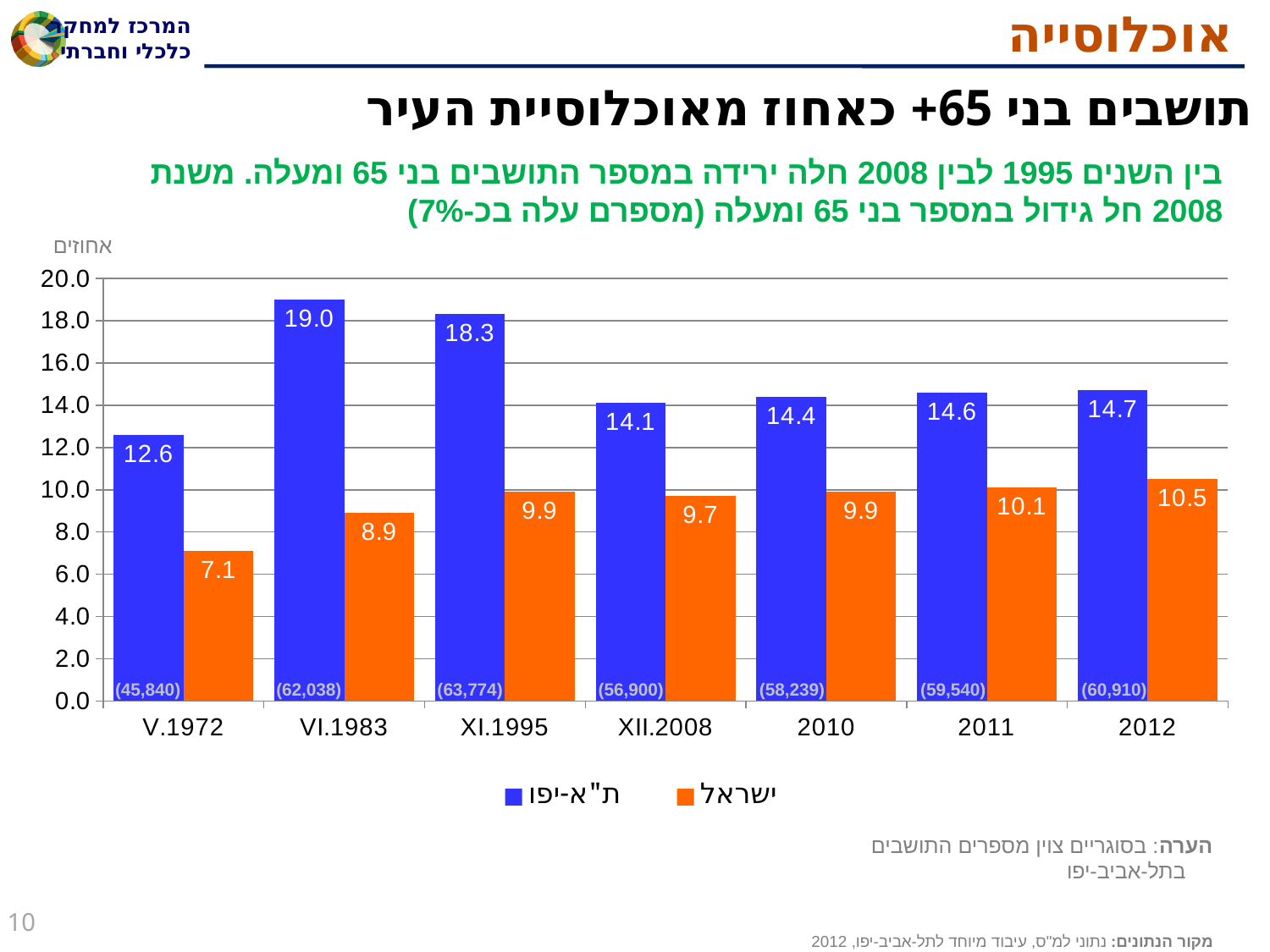
What is the value for ת"א-יפו in VI.1983? 19.0 What is the value for ישראל in 2012? 10.5 What is the value for ת"א-יפו in XII.2008? 14.1 Which category has the lowest value for ישראל? V.1972 How many categories are shown on the x axis? 7 What is the difference between the ת"א-יפו and ישראל values in XI.1995? 8.4 How many series does the legend list? 2 Do the values for ישראל rise or fall from XII.2008 to 2012? rise Which is larger in 2010: the value for ת"א-יפו or the value for ישראל? ת"א-יפו Which category has the highest value for ת"א-יפו? VI.1983 What number is printed in parentheses at the base of the ת"א-יפו bar for 2012? (60,910) What type of chart is shown on the slide? bar chart